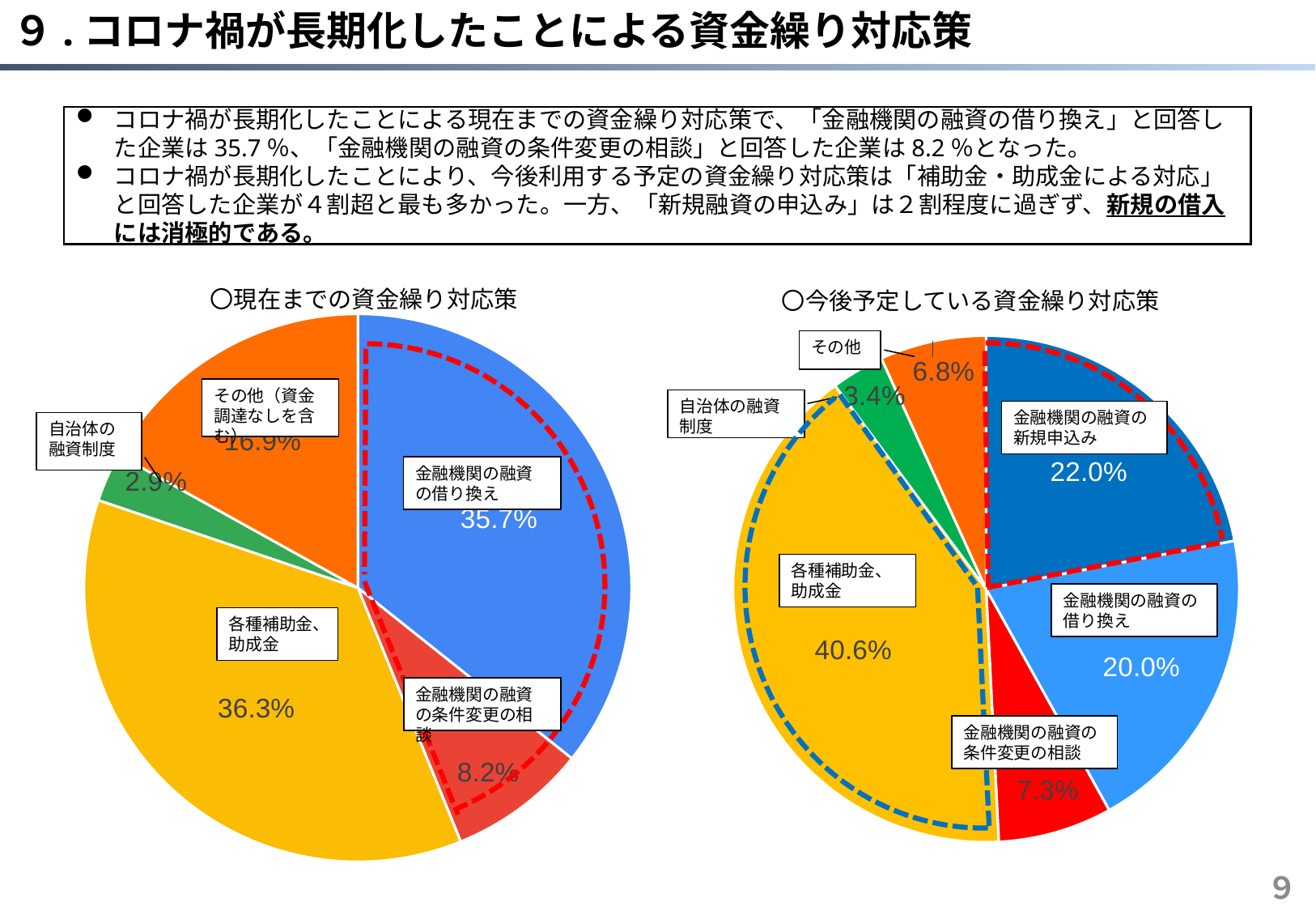
In the right pie chart (今後予定している資金繰り対応策), which is larger: 金融機関の融資の新規申込み or 金融機関の融資の借り換え? 金融機関の融資の新規申込み In the right pie chart (今後予定している資金繰り対応策), what share is shown for 金融機関の融資の新規申込み? 22.0% In the left pie chart (現在までの資金繰り対応策), what share is shown for 各種補助金、助成金? 36.3% In the left pie chart (現在までの資金繰り対応策), what is the difference between the shares for 各種補助金、助成金 and 金融機関の融資の借り換え? 0.6% In the right pie chart (今後予定している資金繰り対応策), what share is shown for 各種補助金、助成金? 40.6% In the left pie chart (現在までの資金繰り対応策), what share is shown for 自治体の融資制度? 2.9% In the right pie chart (今後予定している資金繰り対応策), what share is shown for その他? 6.8% In the right pie chart (今後予定している資金繰り対応策), which category has the largest share? 各種補助金、助成金 How many categories does the right pie chart (今後予定している資金繰り対応策) show? 6 What type of chart is used on this slide? Pie chart In the left pie chart (現在までの資金繰り対応策), what share is shown for 金融機関の融資の借り換え? 35.7% In the left pie chart (現在までの資金繰り対応策), which category has the smallest share? 自治体の融資制度